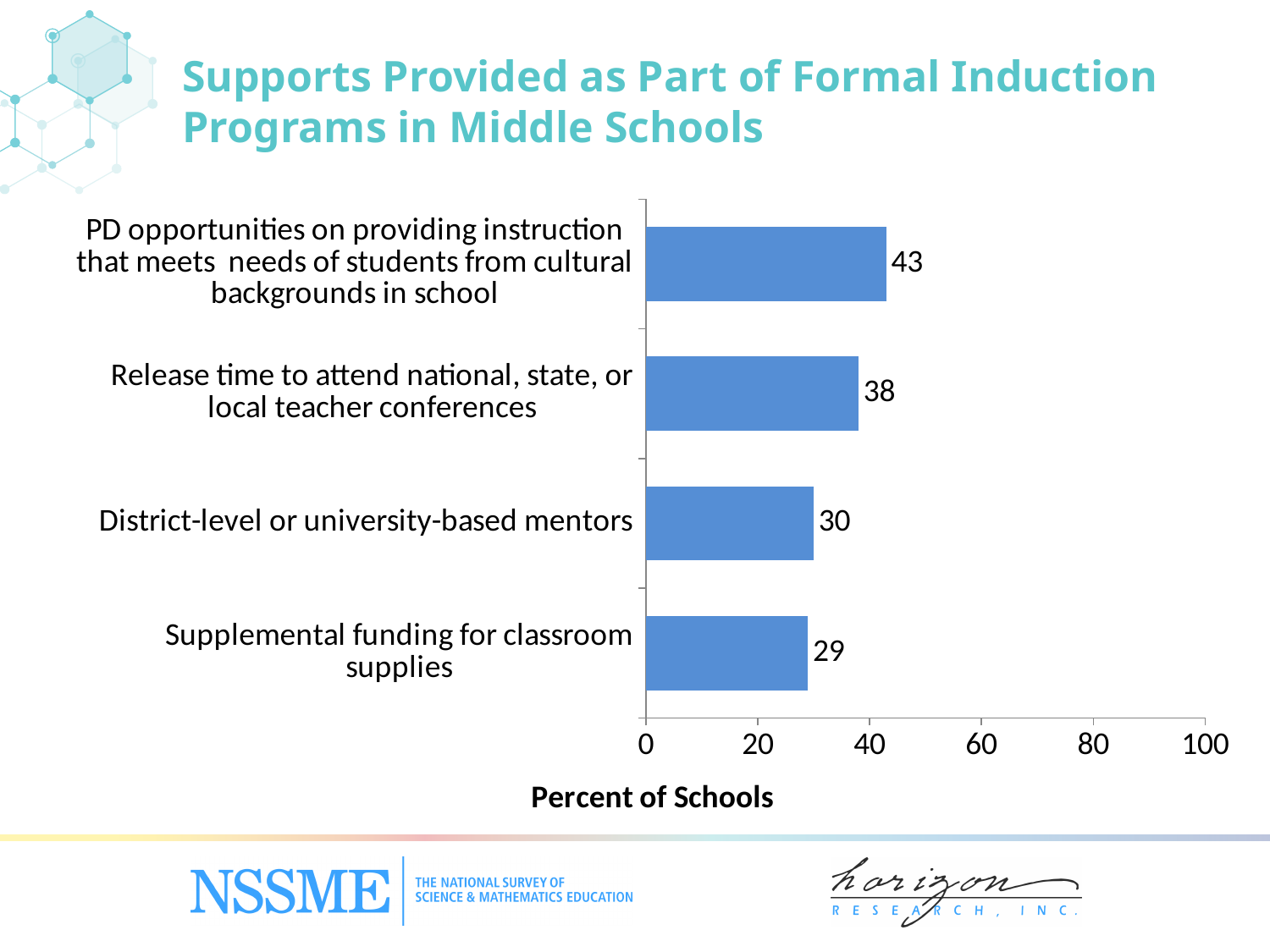
Which is larger: the value for district-level or university-based mentors or the value for release time to attend teacher conferences? Release time to attend national, state, or local teacher conferences What percent of schools provide release time to attend national, state, or local teacher conferences? 38 What kind of chart is shown on the slide? Bar chart What is the difference between the values for PD opportunities on providing instruction that meets needs of students from cultural backgrounds and release time to attend teacher conferences? 5 What percent of schools provide district-level or university-based mentors? 30 What is the label of the horizontal axis? Percent of Schools Which support has the lowest percent of schools? Supplemental funding for classroom supplies What is the maximum value shown on the horizontal axis? 100 Is the value for PD opportunities on providing instruction that meets needs of students from cultural backgrounds greater or less than 40? greater What is the value for supplemental funding for classroom supplies? 29 How many supports are shown in the chart? 4 Which support has the highest percent of schools? PD opportunities on providing instruction that meets needs of students from cultural backgrounds in school